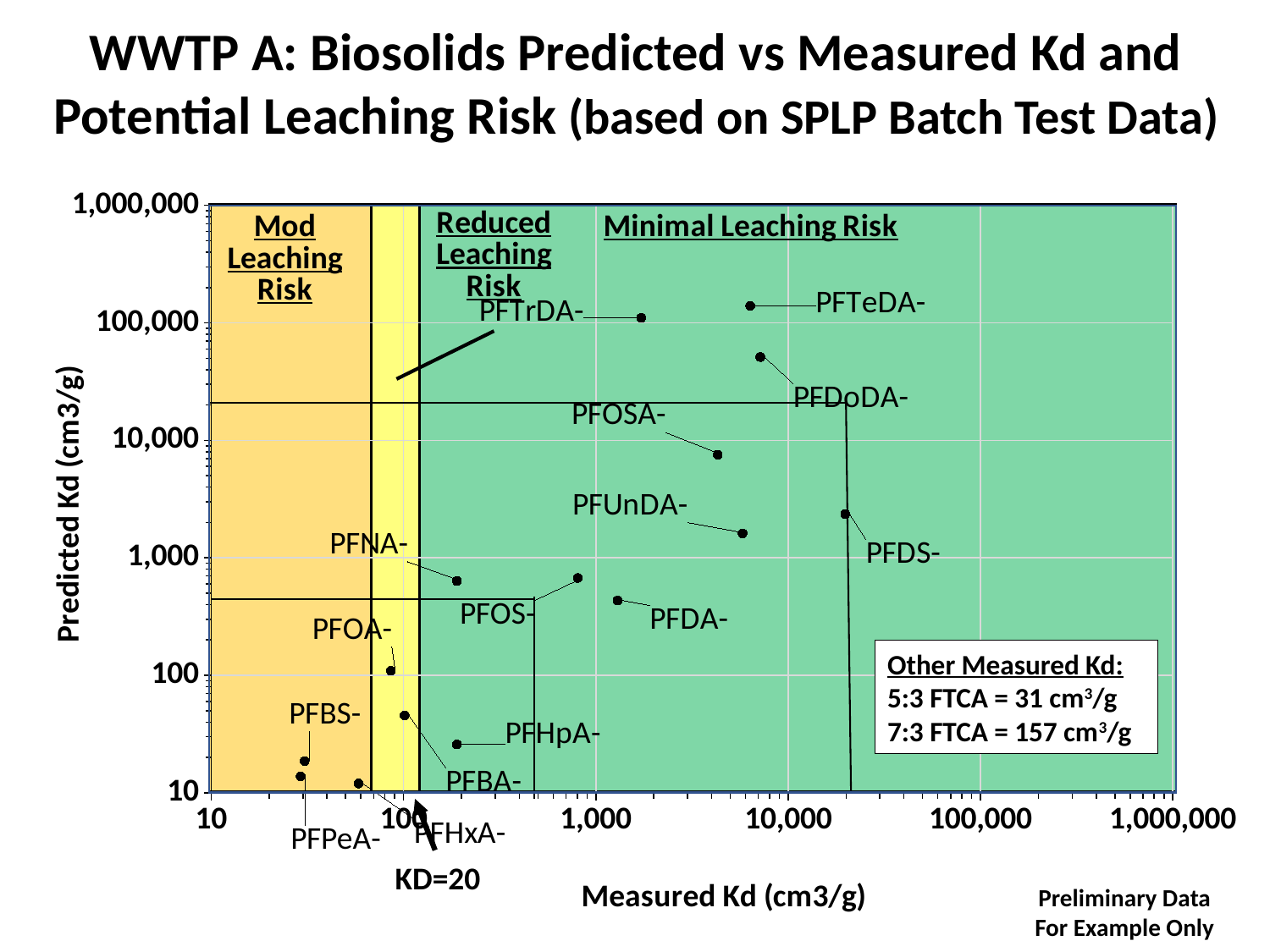
Is the predicted Kd for PFHpA- greater or less than 100? less Is the predicted Kd for PFTeDA- greater or less than 100,000? greater According to the text box on the chart, what is the measured Kd for 5:3 FTCA? 31 cm3/g Which compound has the highest predicted Kd? PFTeDA- Is the predicted Kd for PFBS- greater or less than 100? less How many labeled compounds are plotted on the chart? 15 Which has the higher predicted Kd, PFOSA- or PFUnDA-? PFOSA- What is the title of the x axis? Measured Kd (cm3/g) What kind of chart is shown on the slide? scatter chart Which compound has the highest measured Kd? PFDS-